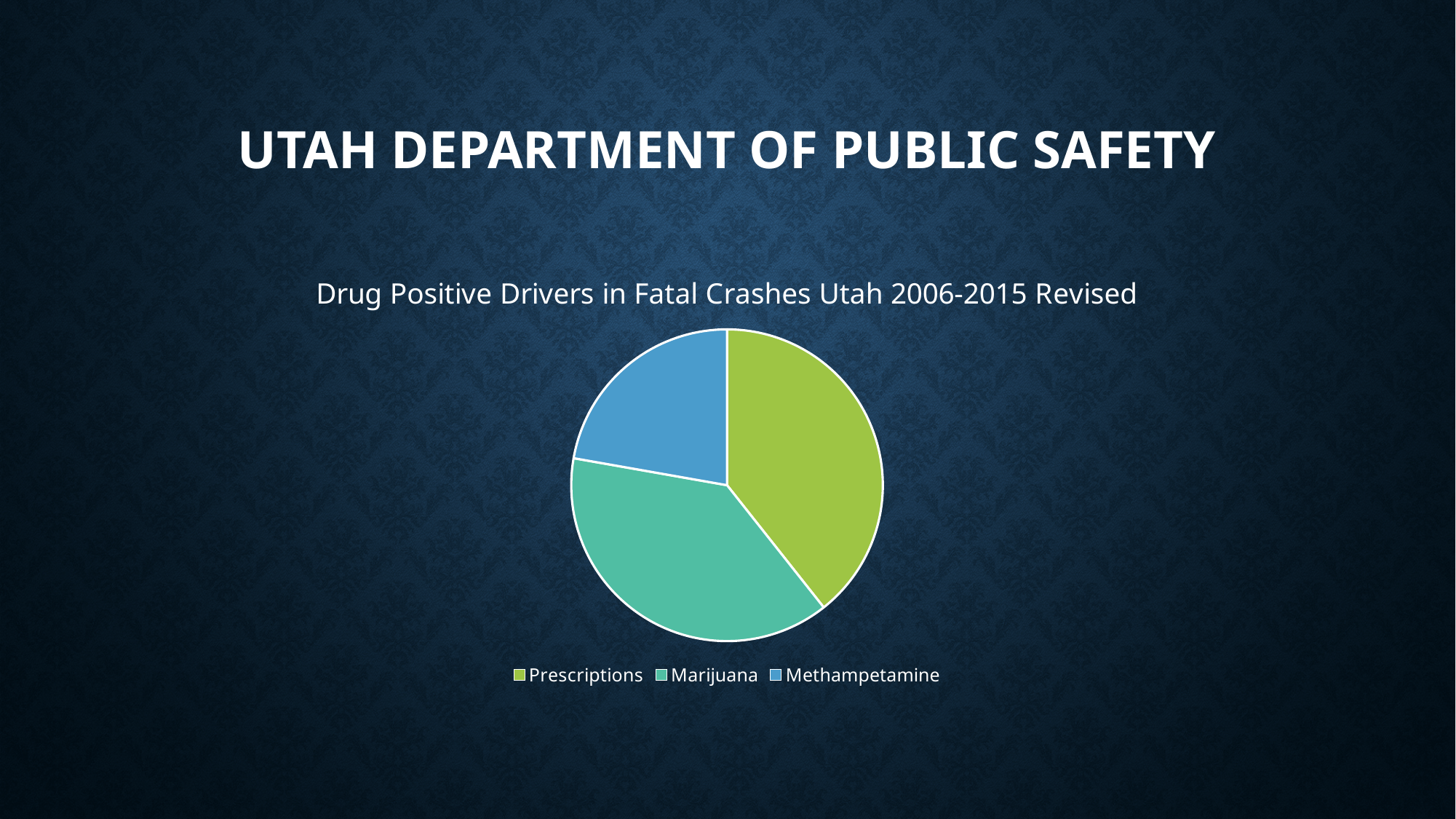
Which colour represents Marijuana in the pie chart? Teal Which category has the smallest slice of the pie? Methampetamine How many entries does the legend list? 3 What is the title of the chart? Drug Positive Drivers in Fatal Crashes Utah 2006-2015 Revised How many slices does the pie chart have? 3 Which slice is larger, Prescriptions or Methampetamine? Prescriptions What kind of chart is shown on the slide? Pie chart